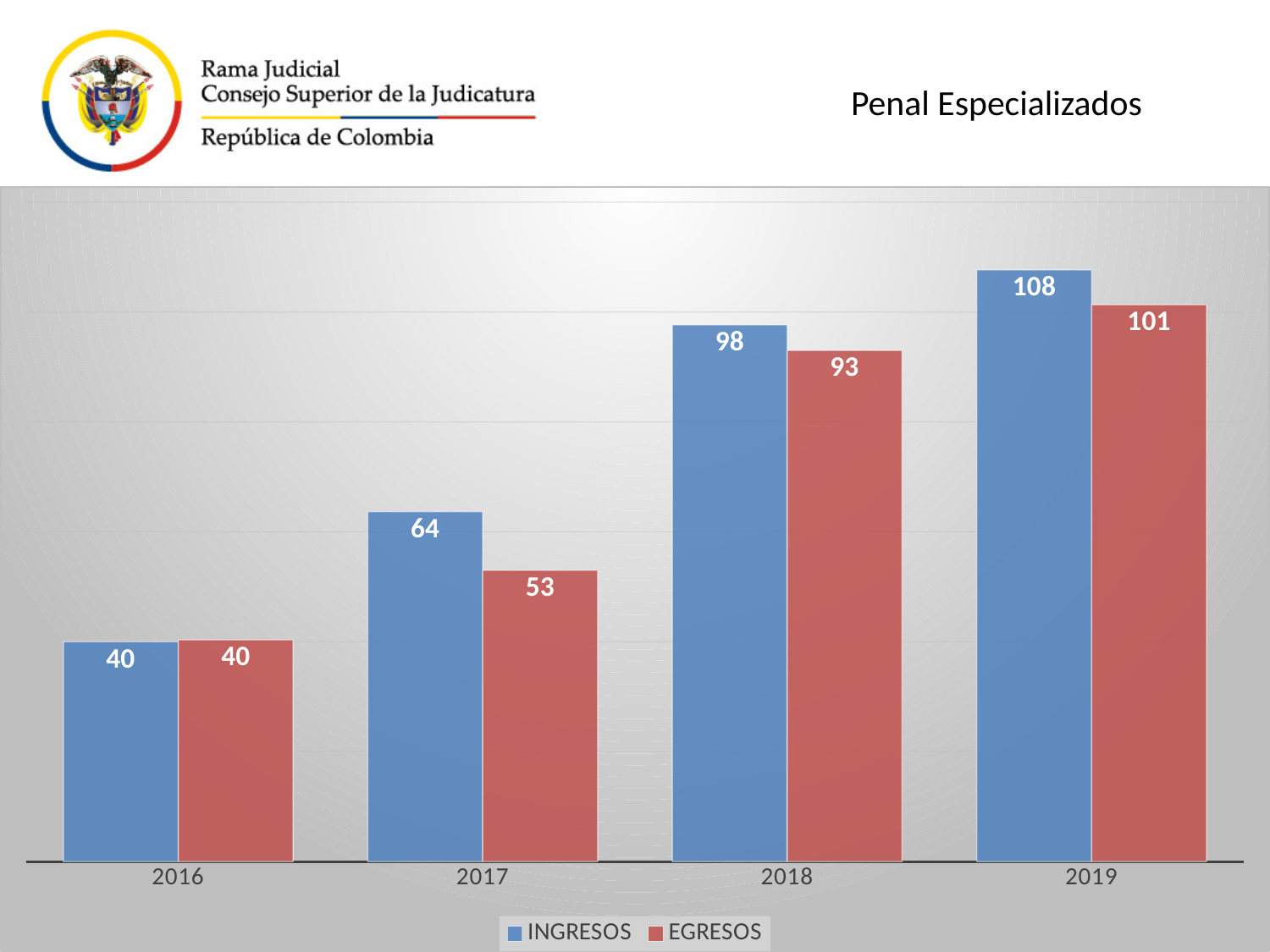
Do the INGRESOS values rise or fall from 2016 to 2019? Rise Which is larger in 2018, INGRESOS or EGRESOS? INGRESOS Which year has the lowest EGRESOS value? 2016 What is the EGRESOS value for 2019? 101 What is the EGRESOS value for 2017? 53 Which year has the highest INGRESOS value? 2019 What is the difference between INGRESOS in 2019 and INGRESOS in 2018? 10 What kind of chart is shown on the slide? Bar chart What is the INGRESOS value for 2018? 98 How many years are shown on the x axis? 4 How many series does the legend list? 2 What is the difference between INGRESOS and EGRESOS in 2017? 11